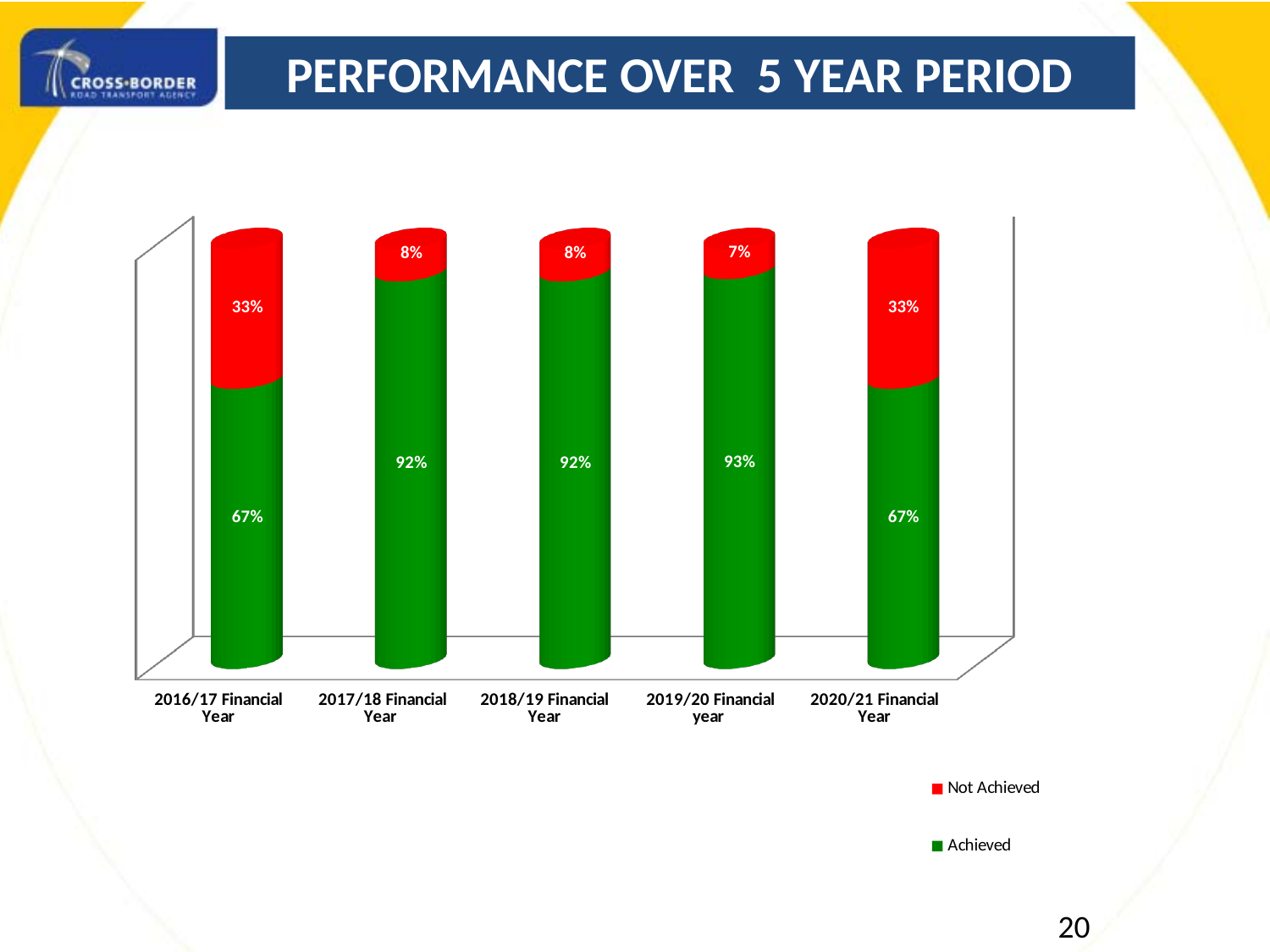
Which financial year has the lowest Not Achieved value? 2019/20 Financial year What is the Achieved value for the 2018/19 Financial Year? 92% Which financial year has the highest Achieved value? 2019/20 Financial year What is the Not Achieved value for the 2020/21 Financial Year? 33% What is the Achieved value for the 2016/17 Financial Year? 67% What is the Not Achieved value for the 2019/20 Financial year? 7% How many series does the legend list? 2 How many financial years are shown on the chart? 5 What colour represents the Not Achieved series? Red What is the difference between the Achieved values for the 2017/18 Financial Year and the 2016/17 Financial Year? 25% Which is larger, the Achieved value for 2019/20 or the Achieved value for 2020/21? 2019/20 What kind of chart is shown on the slide? Stacked bar chart